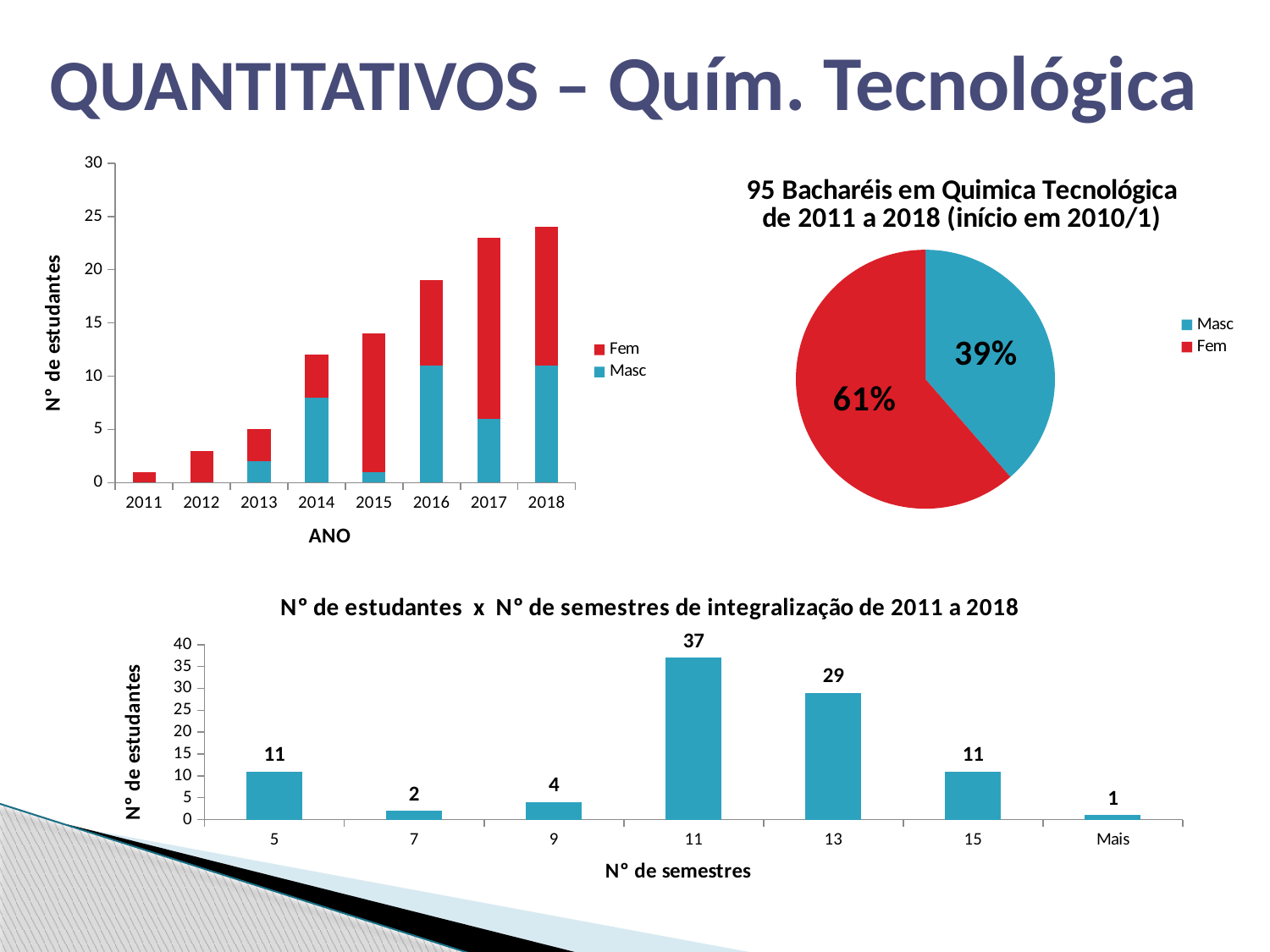
In the bottom chart 'N° de estudantes x N° de semestres de integralização de 2011 a 2018', how many students took 11 semesters? 37 In the pie chart '95 Bacharéis em Quimica Tecnológica de 2011 a 2018', what share is Fem? 61% What type of chart is the top-left chart of N° de estudantes by ANO? stacked bar chart In the bottom chart 'N° de estudantes x N° de semestres de integralização de 2011 a 2018', how many students took 13 semesters? 29 In the top-left stacked bar chart of N° de estudantes by ANO, which year has the lowest total number of students? 2011 In the bottom chart 'N° de estudantes x N° de semestres de integralização de 2011 a 2018', which is larger: the value for 9 semestres or the value for 7 semestres? 9 semestres In the bottom chart 'N° de estudantes x N° de semestres de integralização de 2011 a 2018', what is the difference between the number of students at 11 semesters and at 13 semesters? 8 In the bottom chart 'N° de estudantes x N° de semestres de integralização de 2011 a 2018', how many categories are shown on the x axis? 7 In the bottom chart 'N° de estudantes x N° de semestres de integralização de 2011 a 2018', which number of semesters has the highest number of students? 11 In the top-left stacked bar chart of N° de estudantes by ANO, is the total value for 2018 greater or less than 20? greater In the pie chart '95 Bacharéis em Quimica Tecnológica de 2011 a 2018', what share is Masc? 39% In the bottom chart 'N° de estudantes x N° de semestres de integralização de 2011 a 2018', which category has the lowest number of students? Mais